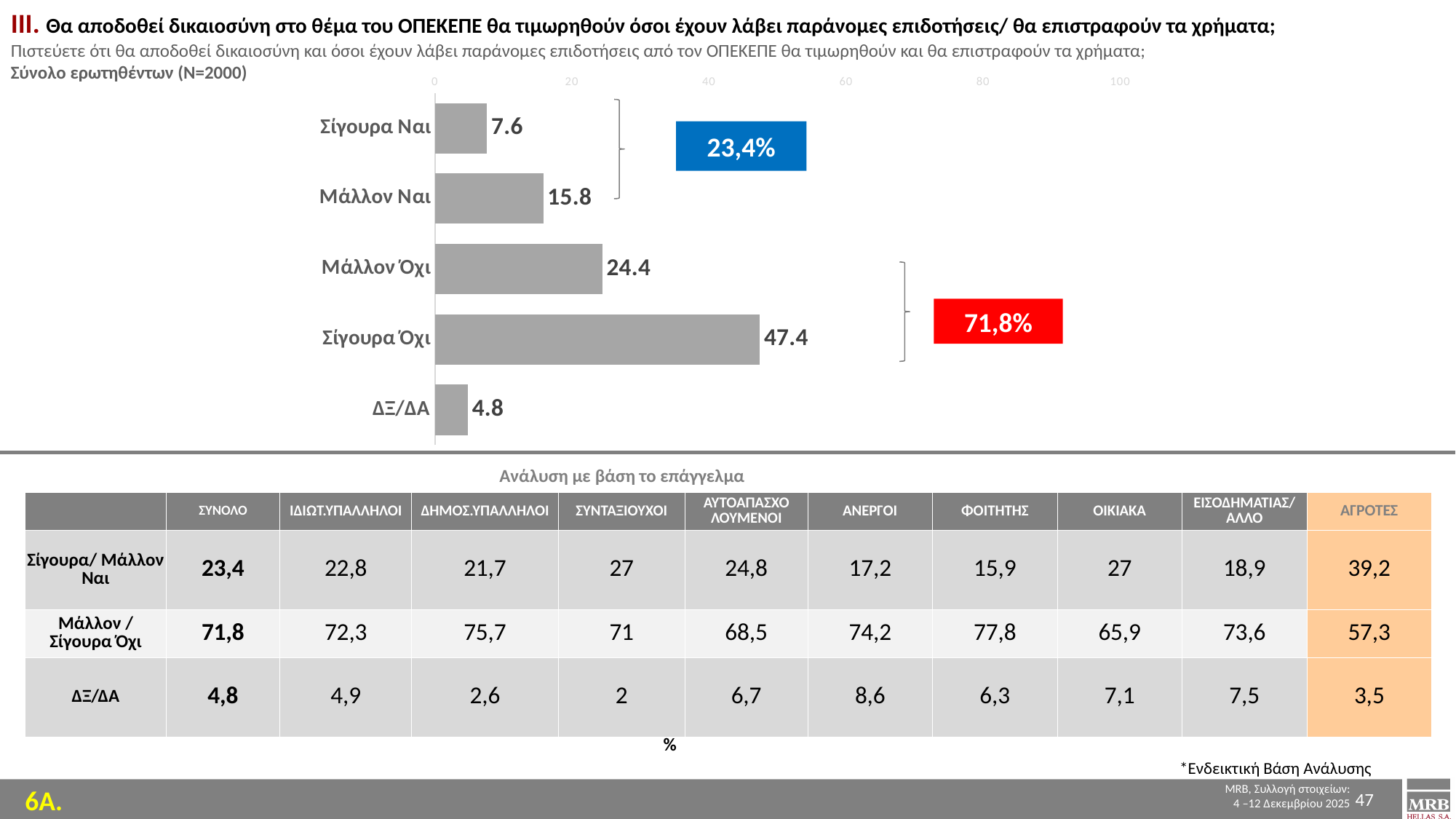
Is the value for Σίγουρα Όχι greater or less than 40? greater What is the value for Σίγουρα Όχι in the bar chart? 47.4 What is the value for ΔΞ/ΔΑ in the bar chart? 4.8 What kind of chart is shown on the slide? bar chart What percentage is shown in the red callout box next to the bar chart? 71,8% What is the difference between the values for Μάλλον Ναι and Σίγουρα Ναι? 8.2 Which category has the highest value in the bar chart? Σίγουρα Όχι Which category has the lowest value in the bar chart? ΔΞ/ΔΑ What is the difference between the values for Σίγουρα Όχι and Μάλλον Όχι? 23.0 What is the value for Μάλλον Ναι in the bar chart? 15.8 How many categories are shown in the bar chart? 5 Which is larger, the value for Μάλλον Όχι or the value for Μάλλον Ναι? Μάλλον Όχι